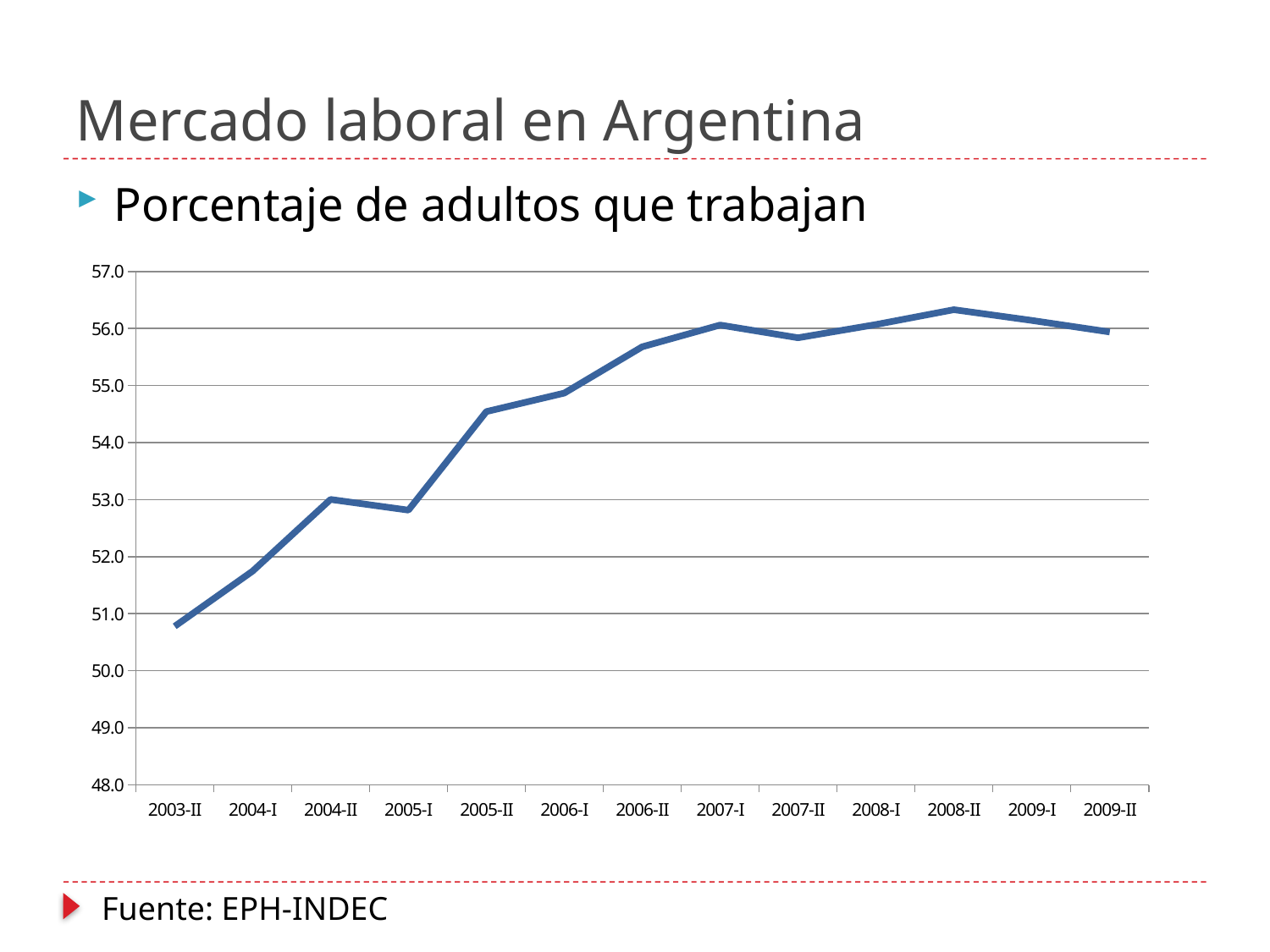
How many periods are plotted along the x axis? 13 What kind of chart is shown on the slide? line chart Which is larger, the value for 2003-II or the value for 2009-II? 2009-II Overall, do the values rise or fall from 2003-II to 2009-II? rise Which is larger, the value for 2005-I or the value for 2005-II? 2005-II Is the value for 2003-II greater or less than 52.0? less Which period has the lowest percentage of working adults? 2003-II What is the source cited for the chart data? EPH-INDEC Is the value for 2004-I greater or less than 52.0? less Is the value for 2006-II greater or less than 55.0? greater Which period has the highest percentage of working adults? 2008-II